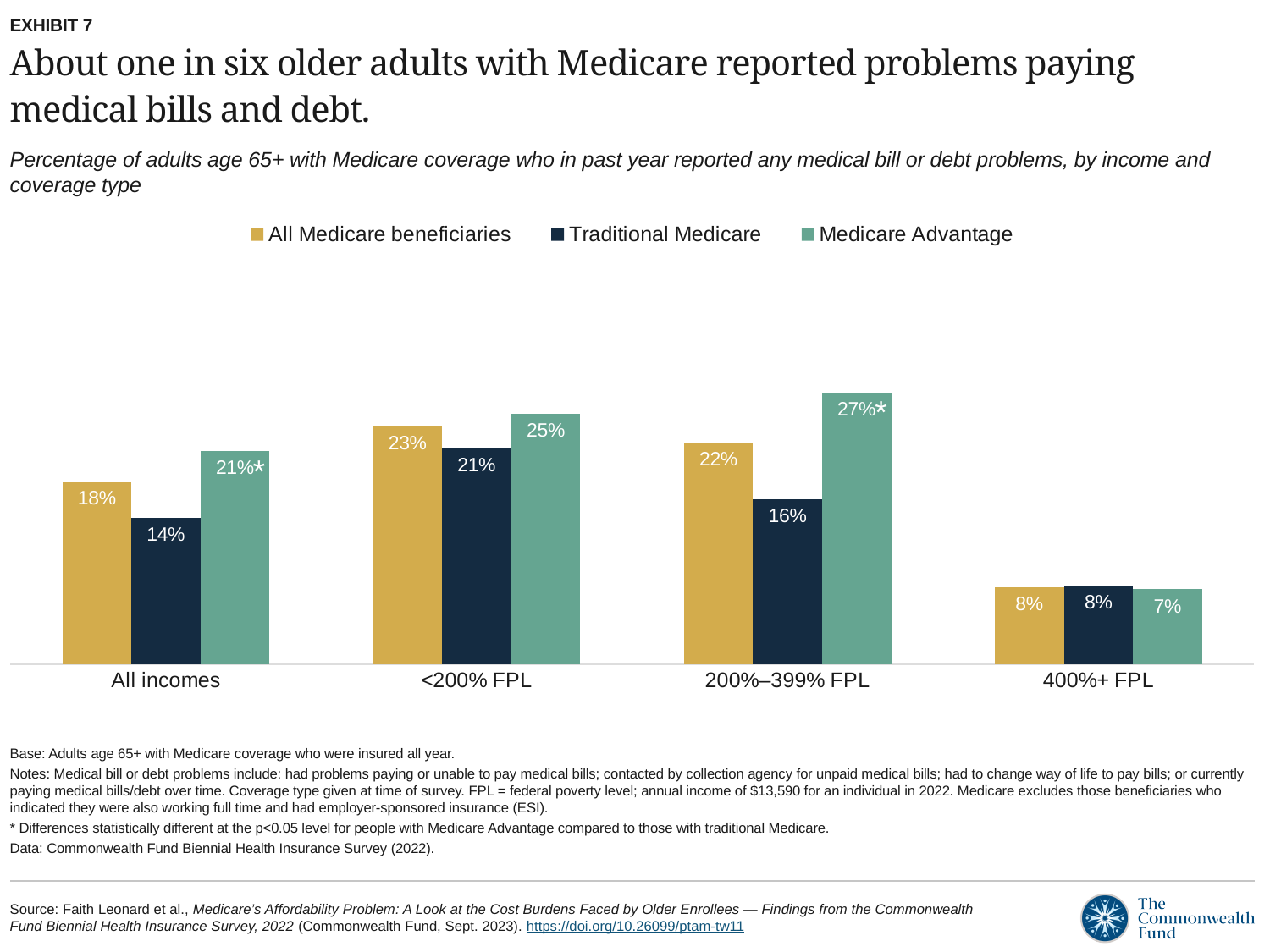
Does the value for All Medicare beneficiaries rise or fall from 200%–399% FPL to 400%+ FPL? Fall What kind of chart is shown on the slide? Bar chart How many series does the legend list? 3 In the <200% FPL category, which is larger: Traditional Medicare or Medicare Advantage? Medicare Advantage Which series is shown in dark navy in the legend? Traditional Medicare Which income category has the highest value for Medicare Advantage? 200%–399% FPL How many income categories are shown on the x axis? 4 Which income category has the lowest value for Traditional Medicare? 400%+ FPL What is the value for All Medicare beneficiaries in the <200% FPL category? 23% What is the difference between Medicare Advantage and Traditional Medicare in the 200%–399% FPL category? 11 percentage points What is the value for Traditional Medicare in the All incomes category? 14% What is the value for Medicare Advantage in the 200%–399% FPL category? 27%